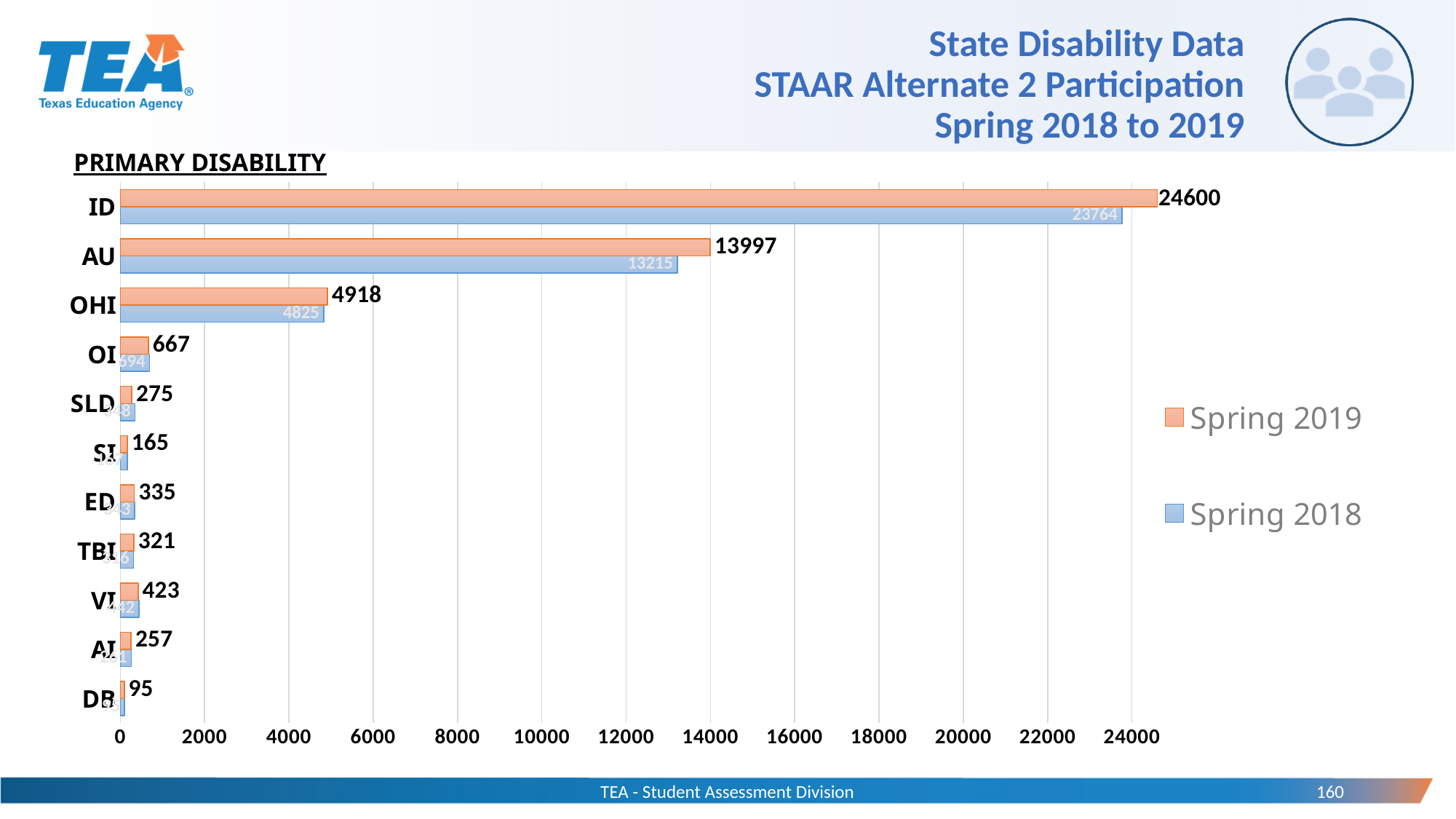
Which primary disability has the lowest Spring 2019 value? DB What is the Spring 2019 value for ID? 24600 What is the difference between the Spring 2019 and Spring 2018 values for ID? 836 What is the difference between the Spring 2019 and Spring 2018 values for AU? 782 What is the Spring 2019 value for OHI? 4918 Which has the larger Spring 2019 value, ED or TBI? ED How many primary disability categories are shown on the chart? 11 What kind of chart is shown on the slide? bar chart How many series does the legend list? 2 What is the Spring 2018 value for AU? 13215 Which primary disability has the highest Spring 2019 value? ID Is the Spring 2018 value for ID greater or less than 20000? greater